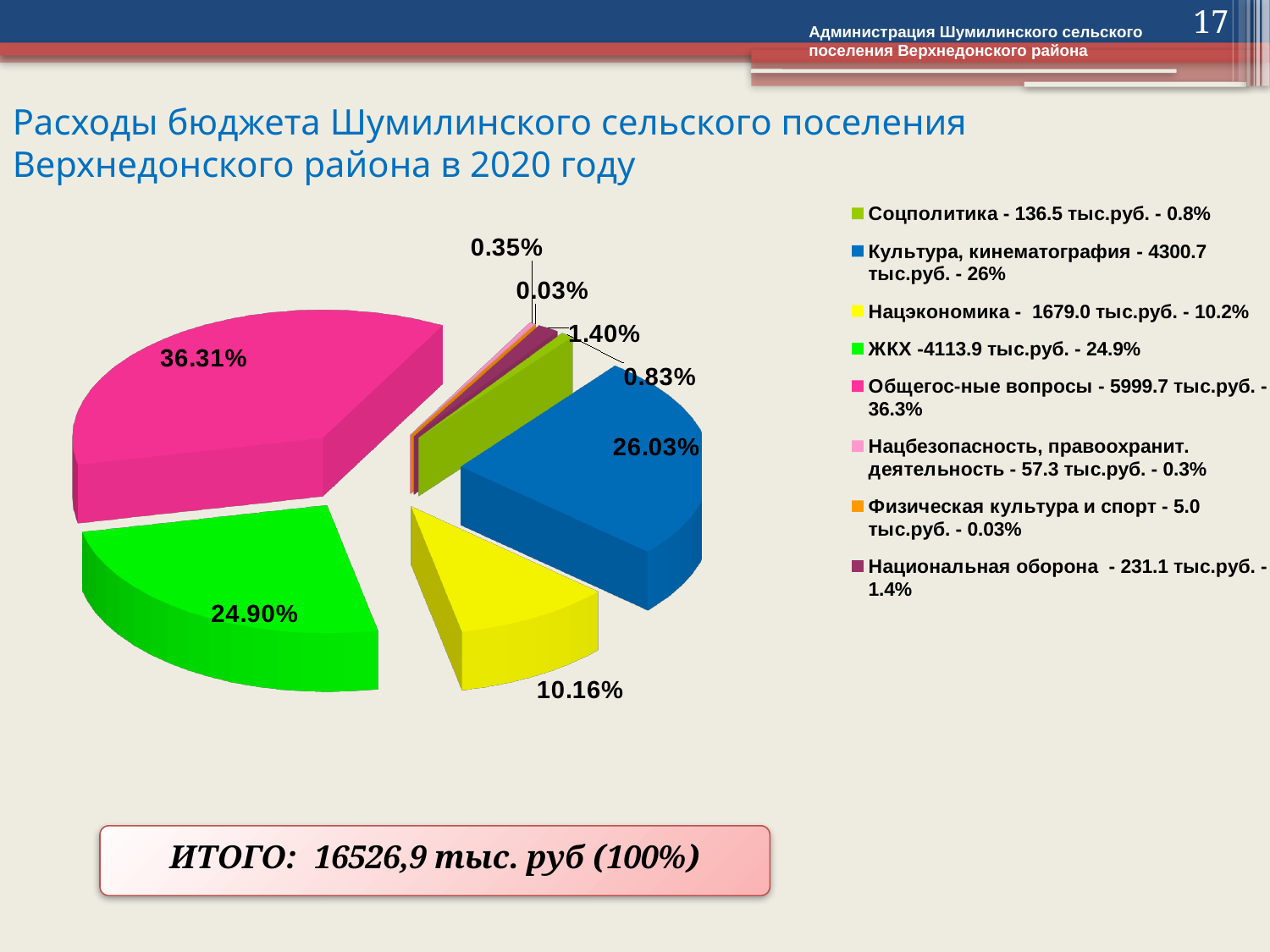
Which slice is larger: Культура, кинематография or ЖКХ? Культура, кинематография What percentage label is shown on the pink slice for Общегос-ные вопросы? 36.31% How many entries does the legend list? 8 According to the legend, how much was spent on Национальная оборона in тыс.руб.? 231.1 тыс.руб. What percentage label is shown on the blue slice for Культура, кинематография? 26.03% What is the difference in percentage points between the Общегос-ные вопросы slice (36.31%) and the ЖКХ slice (24.90%)? 11.41 What percentage label is shown on the slice for Нацэкономика? 10.16% How many slices does the pie chart have? 8 What kind of chart is shown on the slide? pie chart Which category has the smallest share of the pie? Физическая культура и спорт What percentage label is shown on the slice for ЖКХ? 24.90% Which category has the largest share of the pie? Общегос-ные вопросы